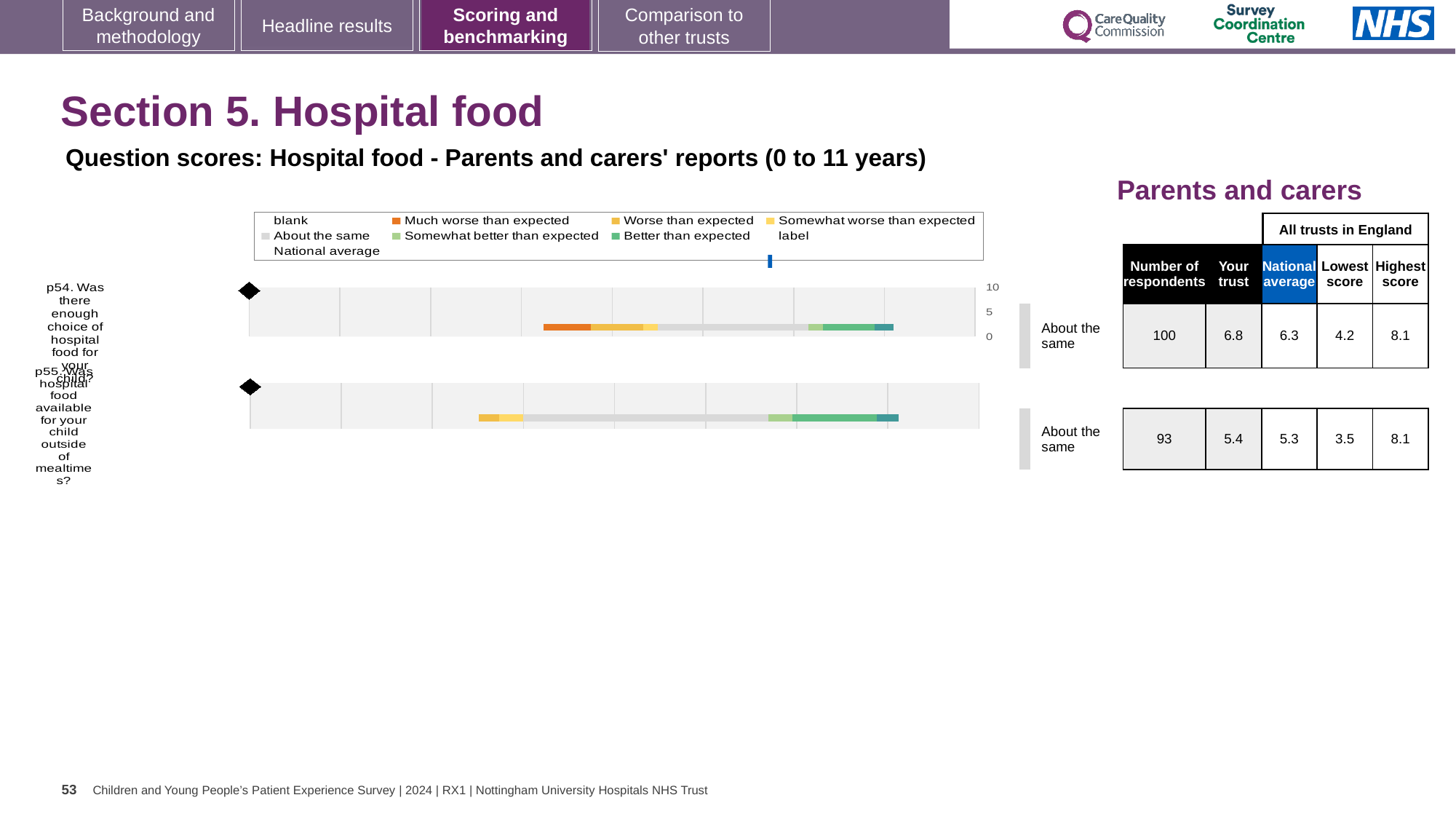
Which colour does the legend use for 'Much worse than expected'? orange How many survey questions (bars) are plotted in the chart? 2 What benchmark category is shown next to the chart for both p54 and p55? About the same Which question has the higher 'Your trust' score in the table beside the chart, p54 or p55? p54 What is the highest value shown on the chart's axis? 10 What kind of chart is shown on the slide? bar chart What is the difference between the 'Your trust' score and the national average for p54 in the table beside the chart? 0.5 According to the table beside the chart, how many respondents answered p54? 100 According to the table beside the chart, what is the 'Your trust' score for p54 (enough choice of hospital food)? 6.8 How many entries does the chart's legend list? 9 According to the table beside the chart, what is the lowest score among all trusts in England for p55? 3.5 According to the table beside the chart, what is the national average for p55 (hospital food available outside of mealtimes)? 5.3